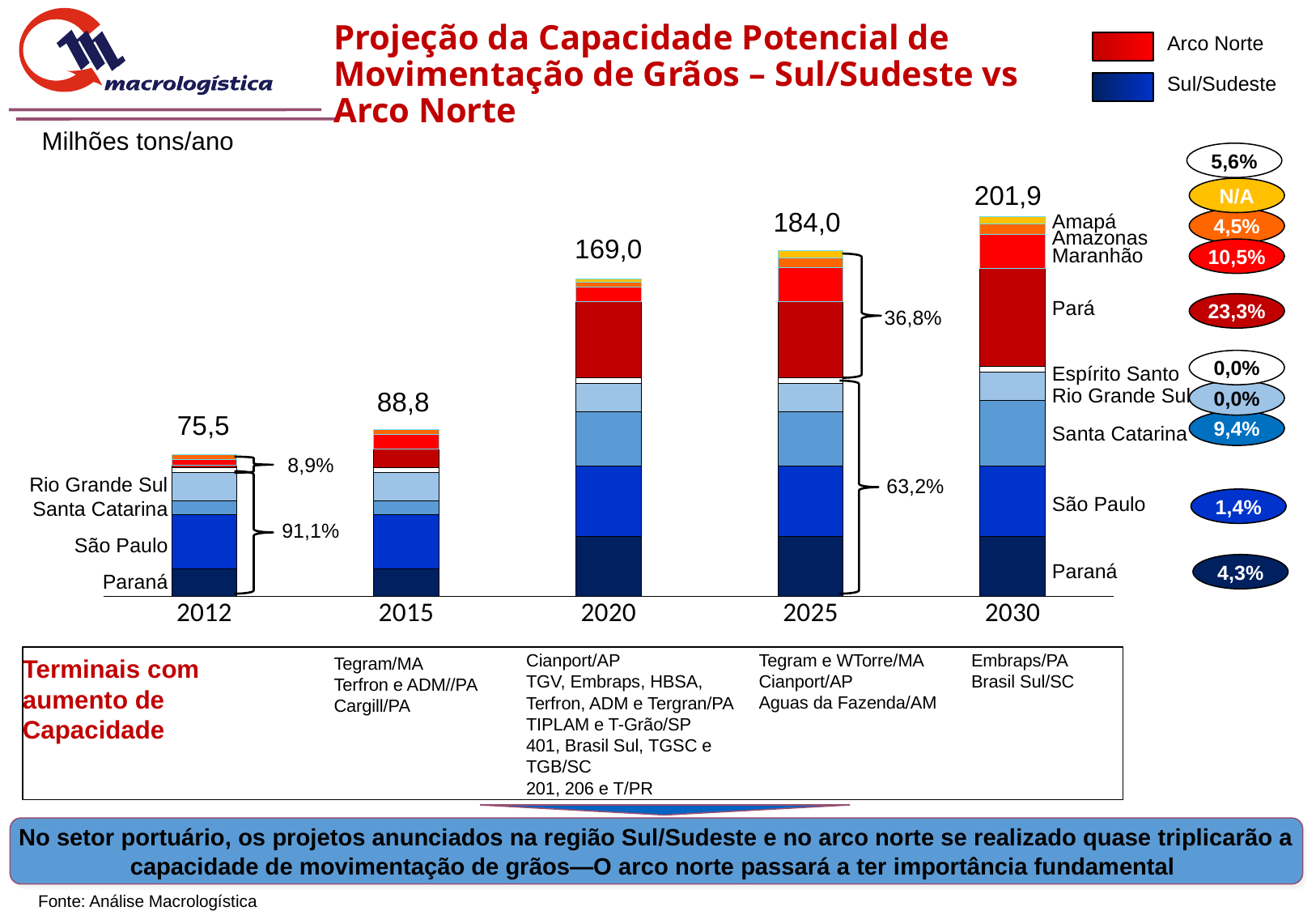
What share of the 2025 total is attributed to Arco Norte? 36,8% How many years are shown on the x axis? 5 Which year has the lowest total capacity? 2012 Do the total values rise or fall from 2012 to 2030? Rise Which year has the highest total capacity? 2030 What is the total capacity shown for 2020? 169,0 Which is larger, the total for 2020 or the total for 2025? 2025 What is the total capacity shown for 2012? 75,5 What is the total capacity shown for 2030? 201,9 How many series does the legend list? 2 What kind of chart is shown? Stacked bar chart What is the difference between the total capacity in 2025 and in 2015? 95,2